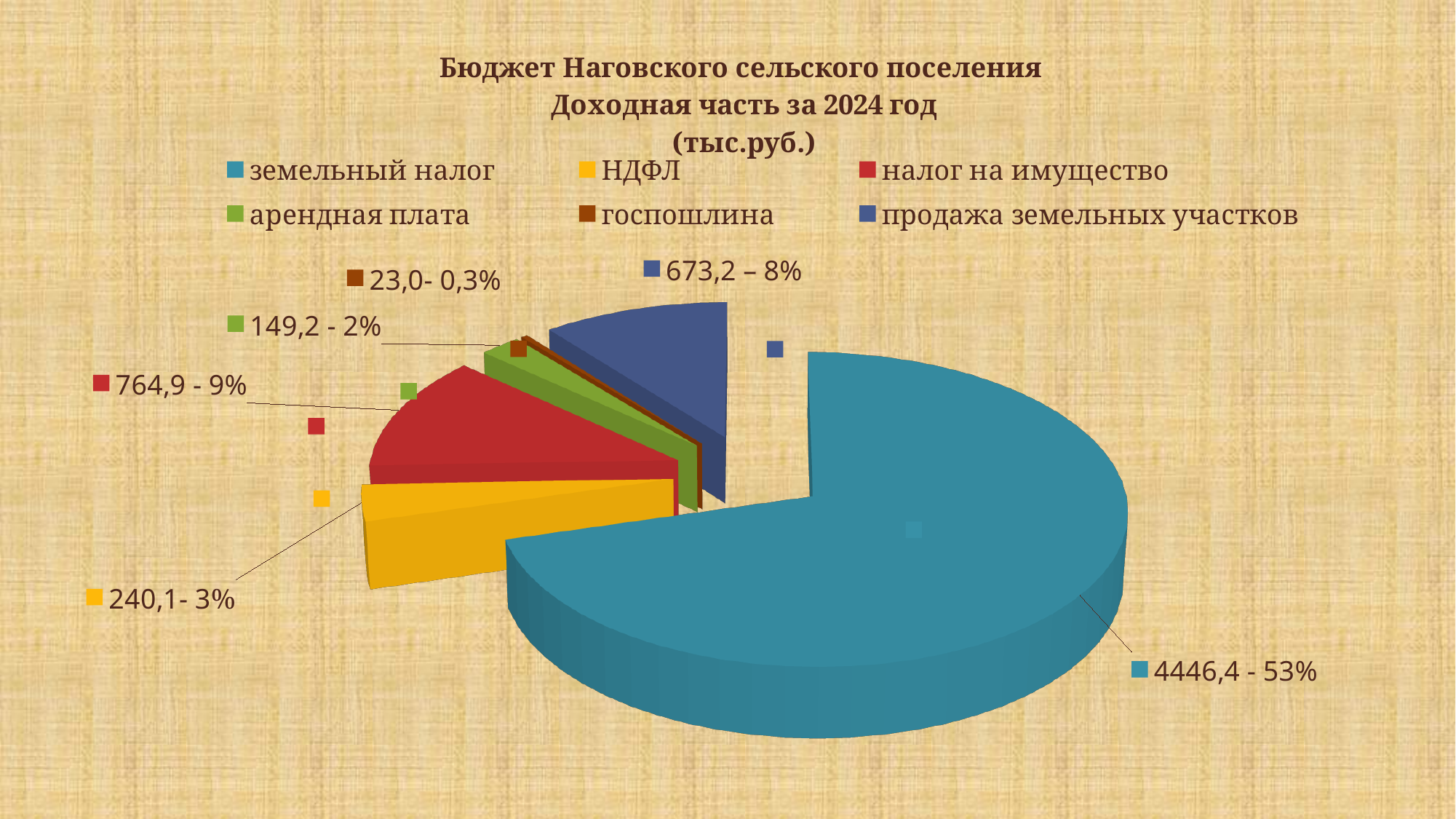
How many categories does the legend list? 6 What is the value for госпошлина? 23,0 What is the value for продажа земельных участков? 673,2 What is the difference between the values for налог на имущество and НДФЛ? 524,8 What share of the pie does НДФЛ represent? 3% Which is larger, налог на имущество or продажа земельных участков? налог на имущество What kind of chart is shown on the slide? pie chart What is the value for налог на имущество? 764,9 Which category has the largest slice of the pie? земельный налог What is the value for земельный налог? 4446,4 Which category has the smallest slice of the pie? госпошлина What share of the pie does арендная плата represent? 2%